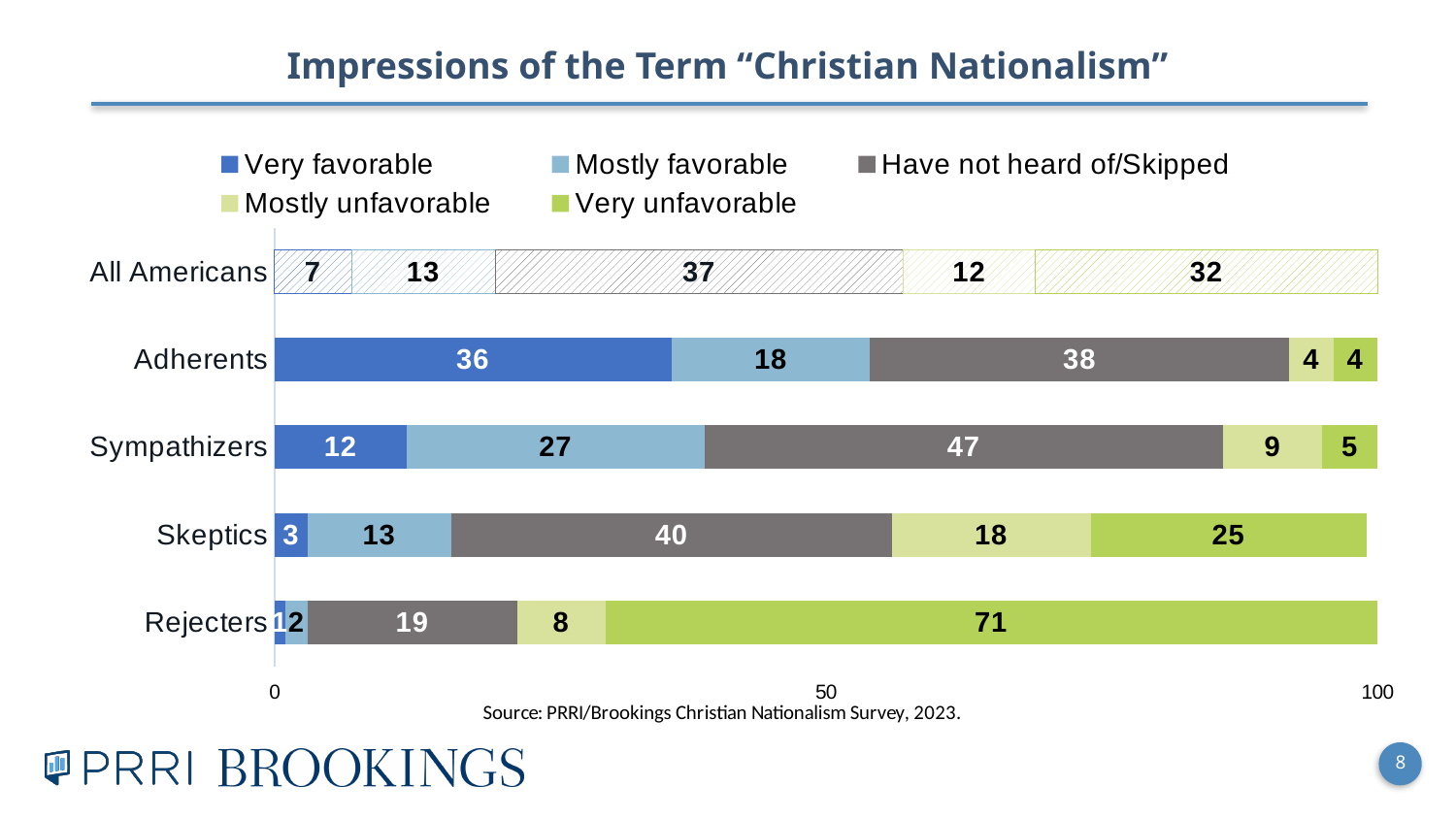
How many series does the legend list? 5 What is the title of the chart? Impressions of the Term "Christian Nationalism" Which group has the lowest Very favorable value? Rejecters Which group has the larger Have not heard of/Skipped value, Adherents or Sympathizers? Sympathizers How many groups (categories) are plotted on the y axis? 5 Which group has the highest Very unfavorable value? Rejecters What kind of chart is shown on the slide? Stacked bar chart What is the Very unfavorable value for Rejecters? 71 What is the total of the stacked bar for Adherents? 100 What is the Very favorable value for Adherents? 36 What is the Have not heard of/Skipped value for Sympathizers? 47 For Skeptics, what is the difference between the Very unfavorable value and the Mostly unfavorable value? 7